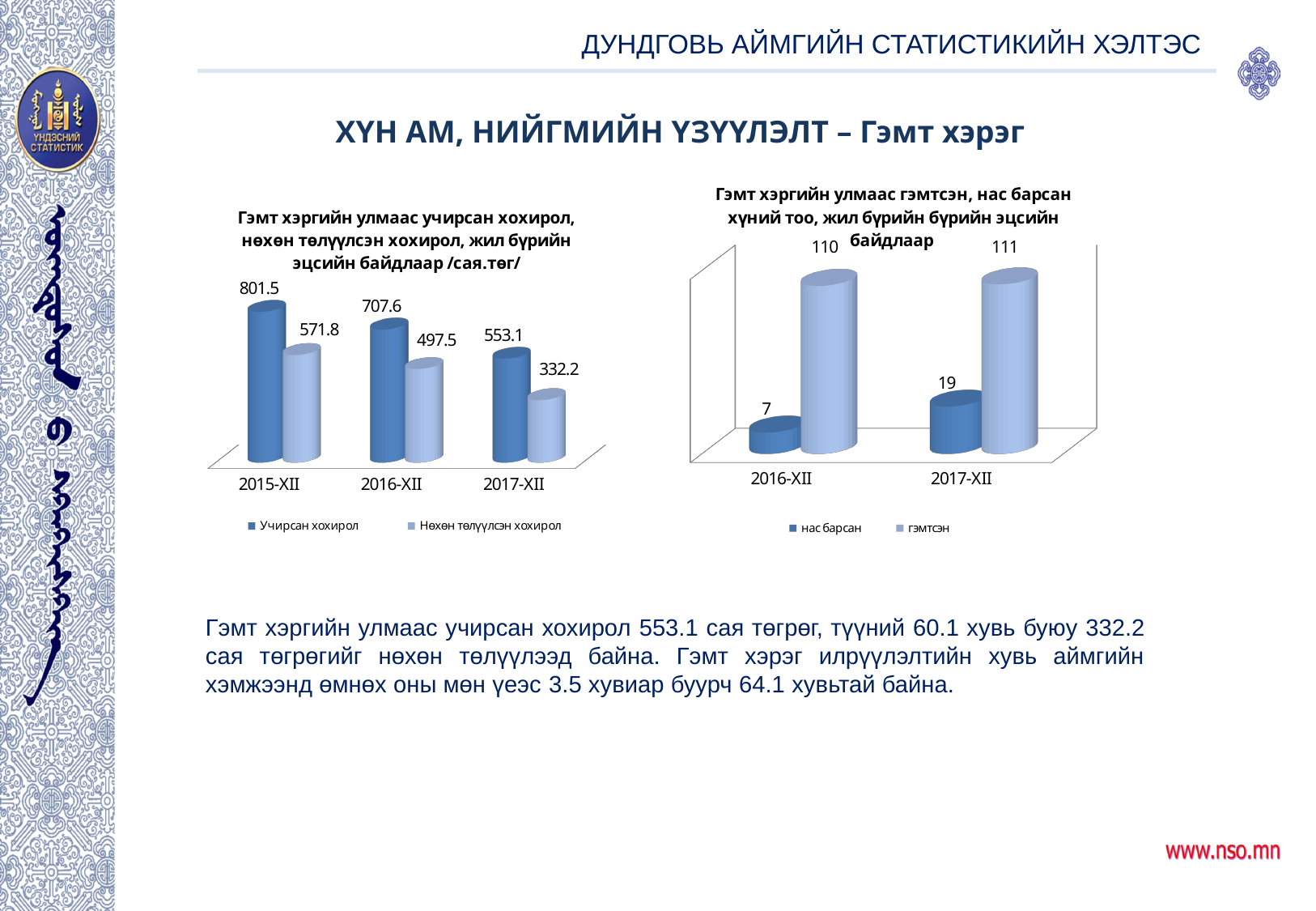
In the right chart, what is the value of нас барсан for 2017-XII? 19 In the right chart, which is larger in 2016-XII: нас барсан or гэмтсэн? гэмтсэн In the left chart, what is the value of Учирсан хохирол for 2015-XII? 801.5 In the left chart, what is the value of Нөхөн төлүүлсэн хохирол for 2017-XII? 332.2 In the left chart, which year has the lowest value for Учирсан хохирол? 2017-XII In the left chart, what is the difference between Учирсан хохирол and Нөхөн төлүүлсэн хохирол in 2016-XII? 210.1 How many series does the legend of the right chart list? 2 In the right chart, what is the difference in нас барсан between 2017-XII and 2016-XII? 12 In the right chart, what is the value of гэмтсэн for 2016-XII? 110 How many categories are shown on the x axis of the left chart? 3 In the left chart, does the value of Учирсан хохирол rise or fall from 2015-XII to 2017-XII? fall What type of chart is the left chart? bar chart